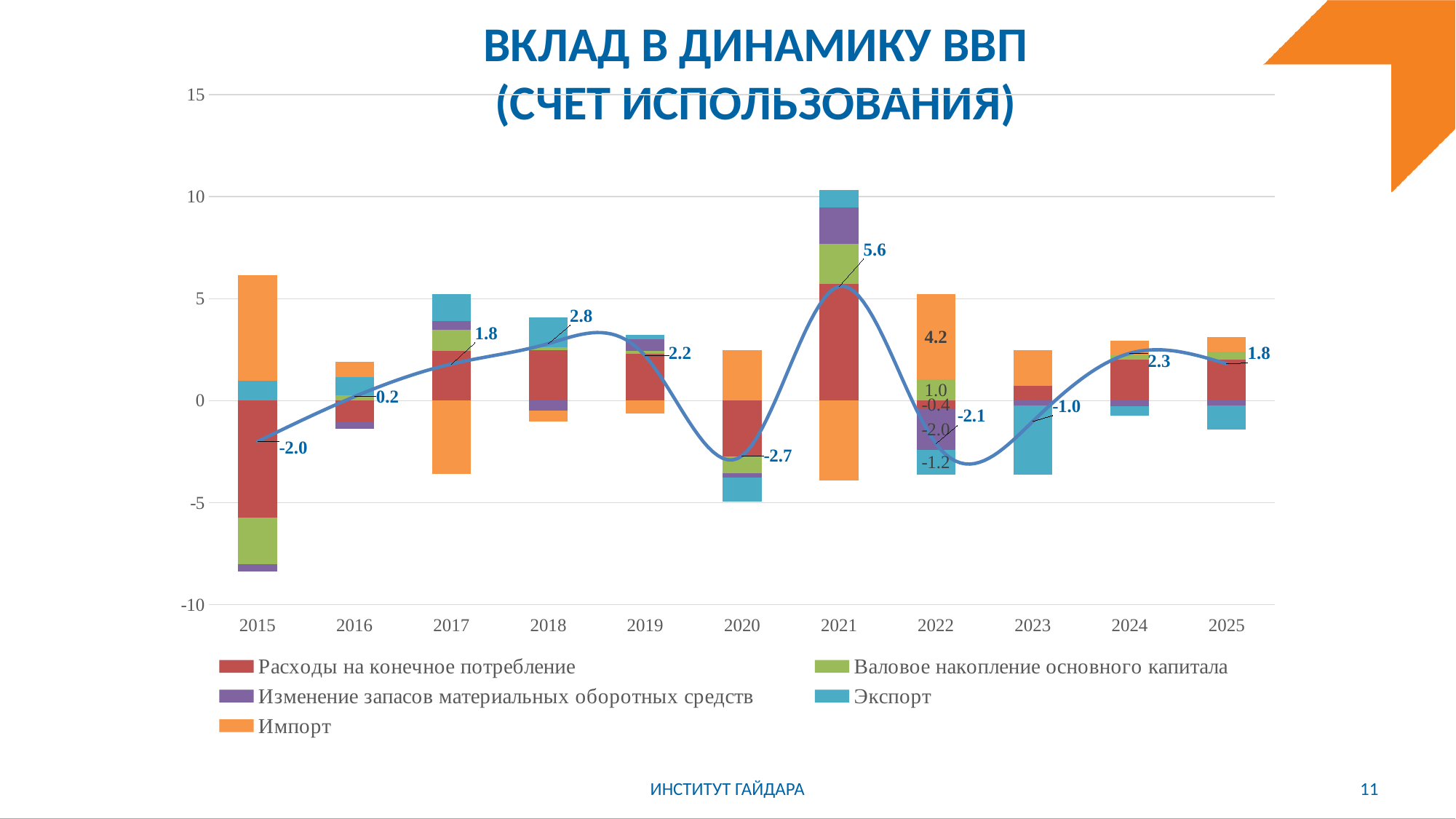
In which year does the line reach its highest labelled value? 2021 What is the labelled value of the Экспорт segment in 2022? -1.2 How many years are shown on the x axis? 11 What kind of chart is shown on the slide? Stacked bar chart with a line What is the labelled value of the line for 2020? -2.7 What is the difference between the line values for 2021 and 2018? 2.8 What is the labelled value of the Импорт segment in 2022? 4.2 In which year does the line reach its lowest labelled value? 2020 Does the line rise or fall from 2022 to 2024? Rises How many series does the legend list? 5 What is the labelled value of the line for 2021? 5.6 Which year has the larger line value, 2018 or 2019? 2018